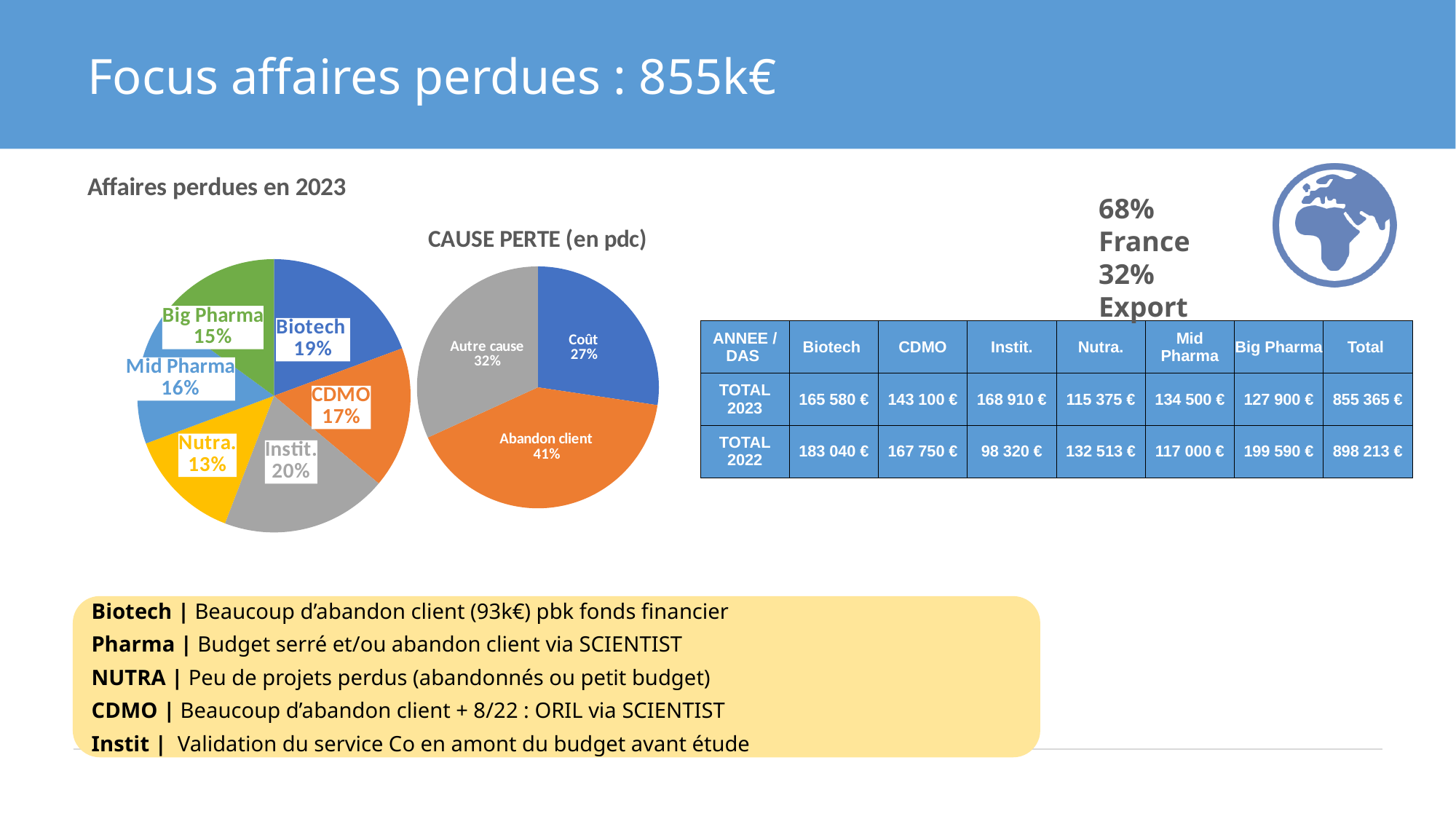
In the 'Affaires perdues en 2023' pie chart, what is the difference between the Instit. share and the Big Pharma share? 5 percentage points In the 'Affaires perdues en 2023' pie chart, what share does Biotech have? 19% What kind of chart is the 'CAUSE PERTE (en pdc)' chart? Pie chart In the 'CAUSE PERTE (en pdc)' pie chart, how many slices are there? 3 In the 'CAUSE PERTE (en pdc)' pie chart, what is the difference between the Abandon client share and the Autre cause share? 9 percentage points In the 'Affaires perdues en 2023' pie chart, which category has the smallest share? Nutra. In the 'CAUSE PERTE (en pdc)' pie chart, which cause has the smallest share? Coût In the 'CAUSE PERTE (en pdc)' pie chart, what share does Abandon client have? 41% In the 'Affaires perdues en 2023' pie chart, what share does Nutra. have? 13% In the 'Affaires perdues en 2023' pie chart, which category has the largest share? Instit. In the 'Affaires perdues en 2023' pie chart, how many categories are shown? 6